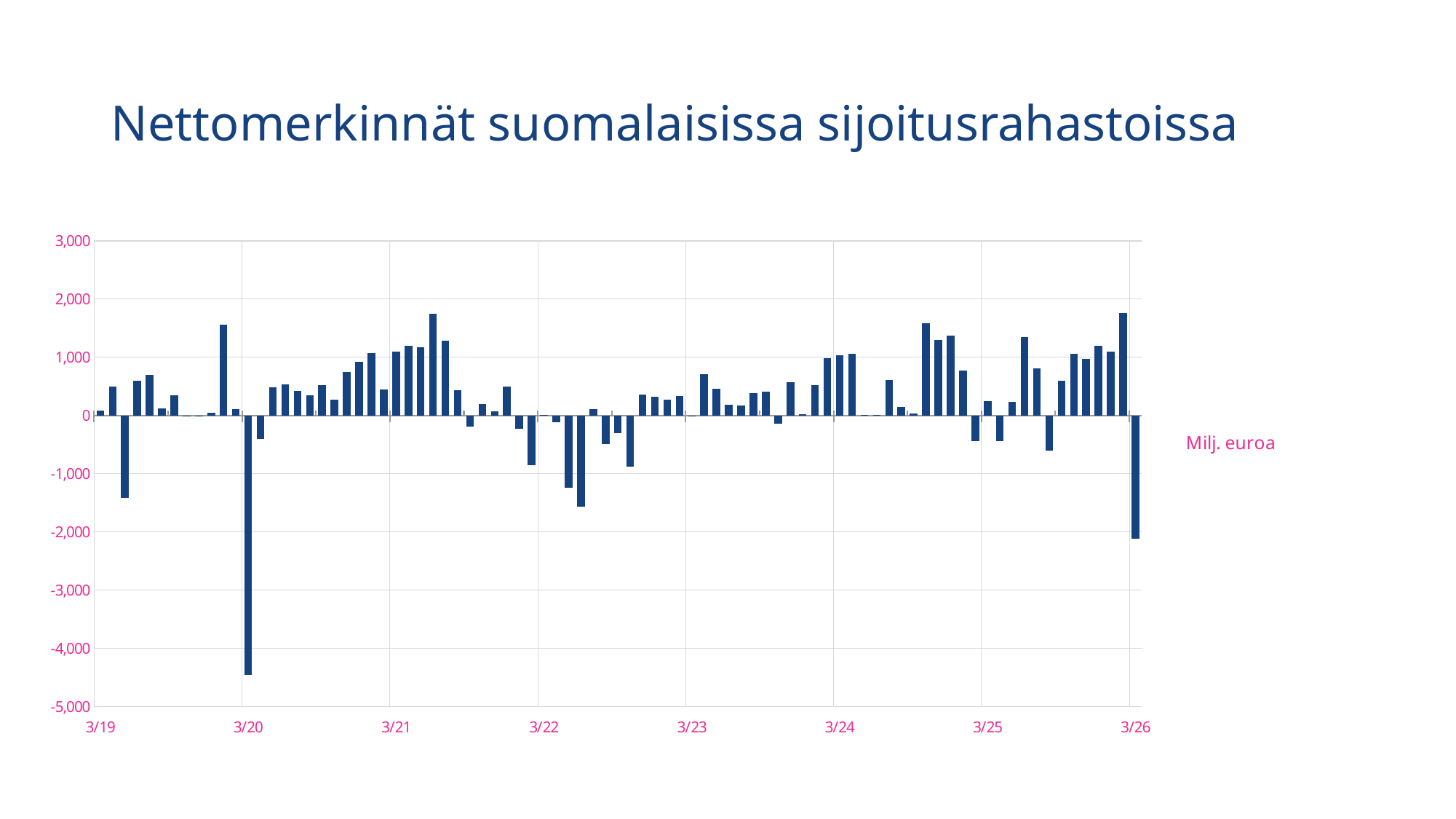
Which has the lower value, 3/20 or 3/26? 3/20 What kind of chart is shown on the slide? bar chart Is the value for 3/20 greater or less than -4,000? less Is the value for 3/19 greater or less than 0? greater Is the value for 3/26 greater or less than -1,000? less How many date labels are shown on the x axis? 8 What is the title of the chart? Nettomerkinnät suomalaisissa sijoitusrahastoissa What unit is indicated next to the chart? Milj. euroa At which labelled x-axis date does the chart show its lowest value? 3/20 Which has the higher value, 3/19 or 3/25? 3/25